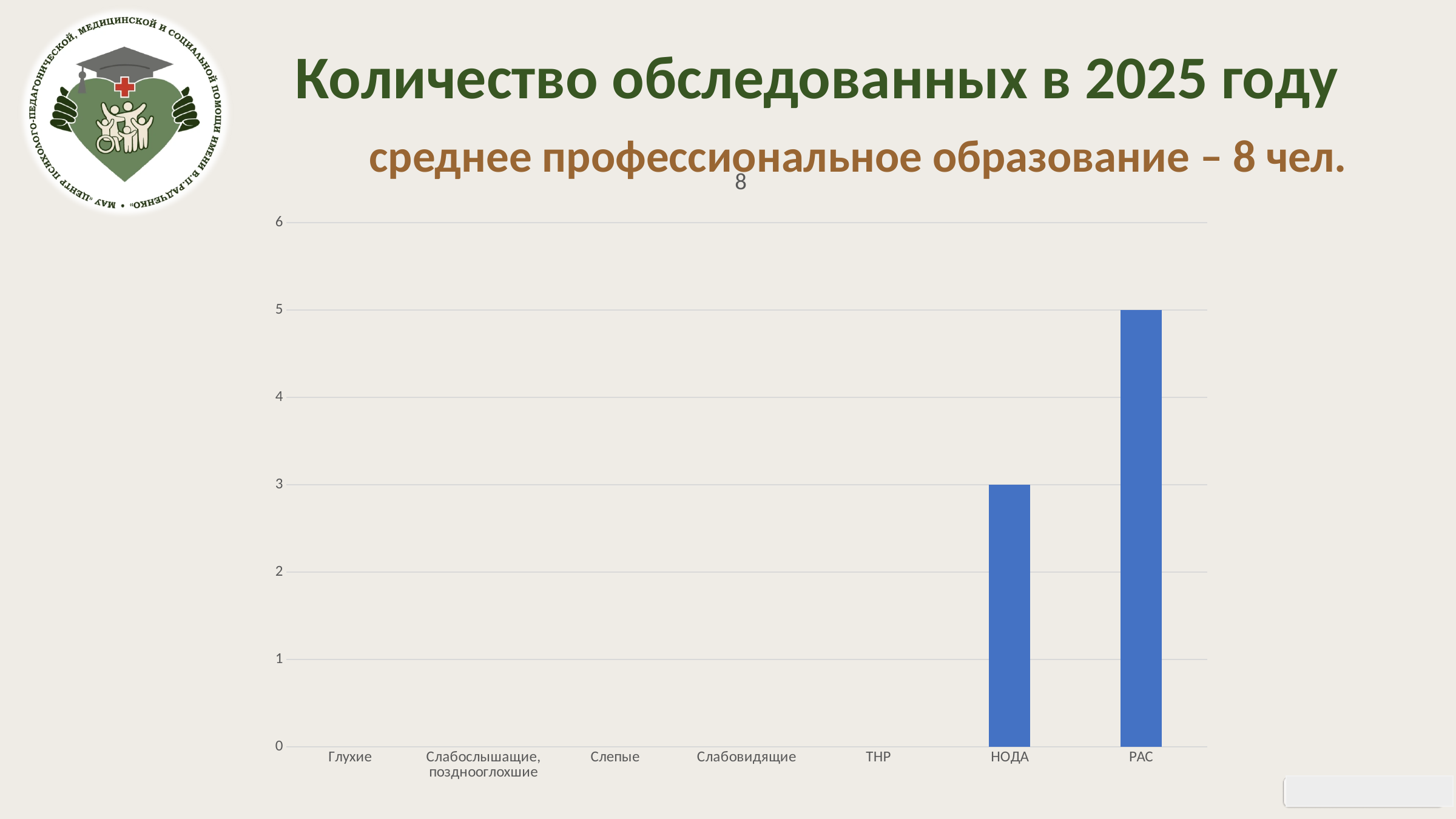
Is the value for НОДА greater or less than 4? less What is the value for РАС? 5 What is the highest value shown on the vertical axis? 6 What kind of chart is shown on the slide? bar chart What is the value for НОДА? 3 How many categories are shown on the x axis of the chart? 7 Which is larger, the value for НОДА or the value for РАС? РАС Is the value for РАС greater or less than 4? greater What colour are the bars in the chart? blue Which category has the highest value? РАС What is the difference between the values for РАС and НОДА? 2